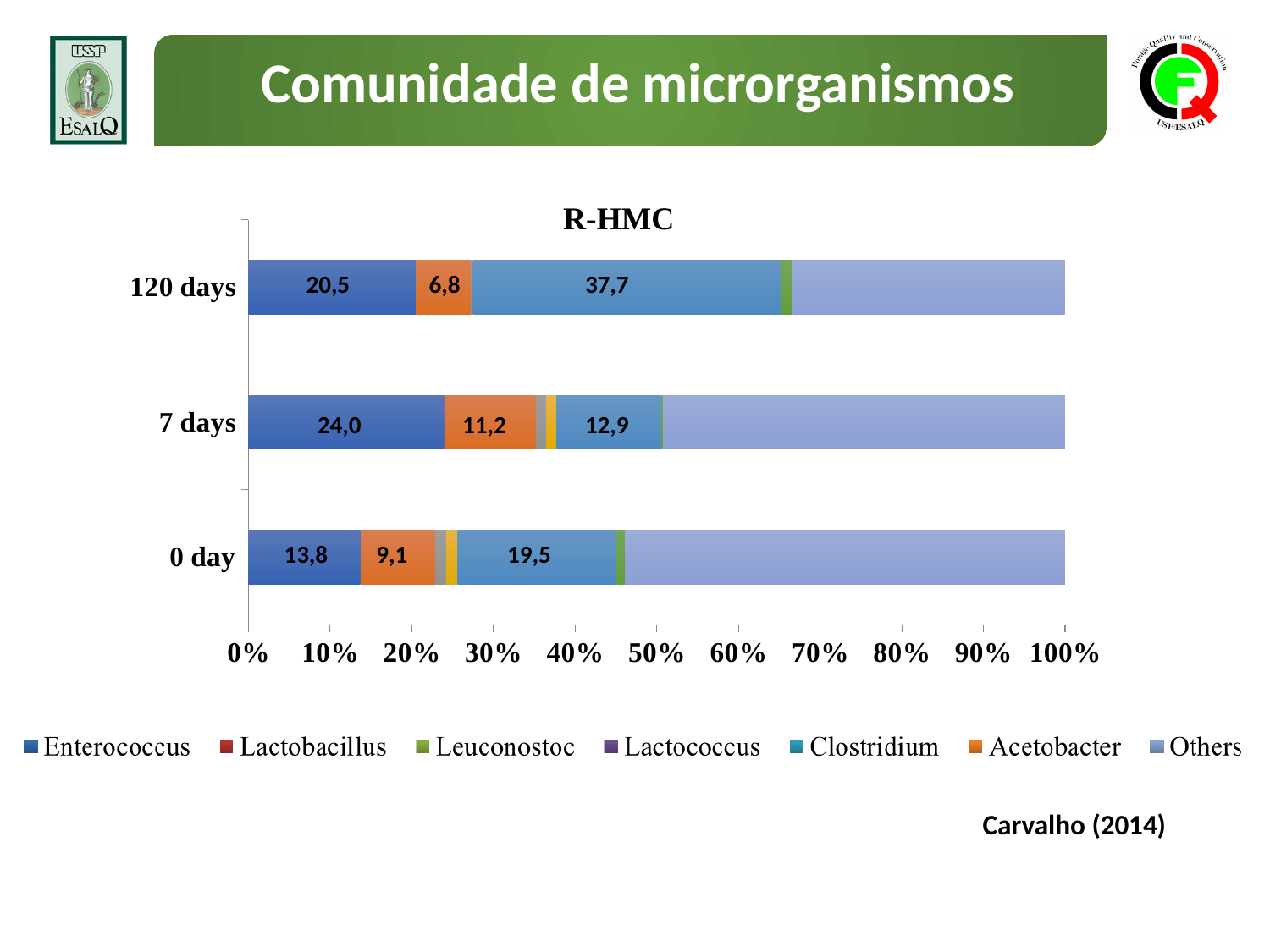
How many series does the legend list? 7 What is the difference between the Clostridium value at 120 days and at 0 day? 18,2 What is the value for Enterococcus at 120 days? 20,5 What kind of chart is shown on the slide? Stacked bar chart Which time point has the highest Enterococcus value? 7 days How many time points (categories) are shown on the chart? 3 Which time point has the lowest Clostridium value? 7 days What is the title of the chart? R-HMC What is the value for Clostridium at 7 days? 12,9 What is the difference between the Enterococcus value at 7 days and at 0 day? 10,2